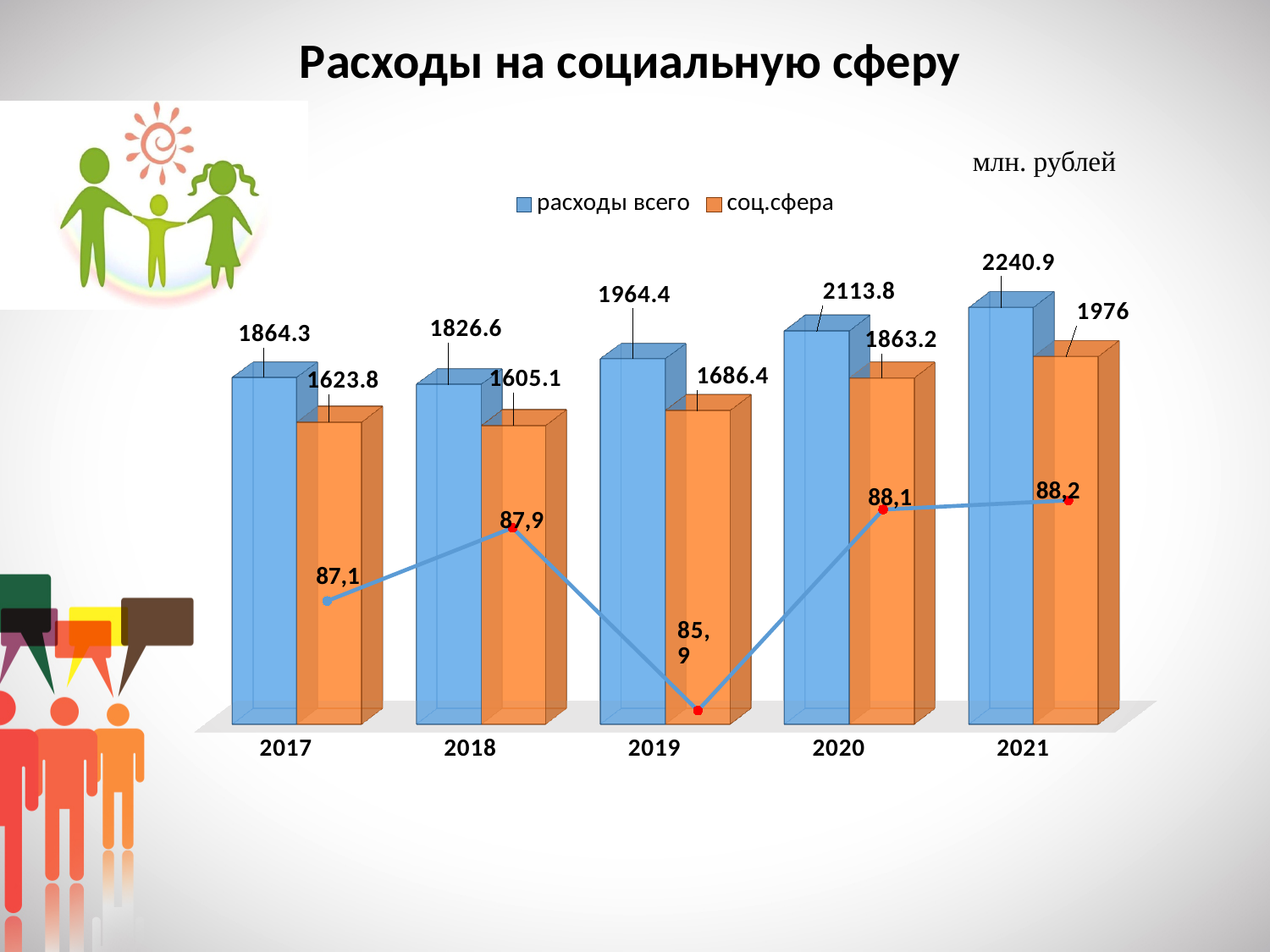
What is the difference between "расходы всего" and "соц.сфера" in 2021? 264.9 Which is larger: "расходы всего" in 2018 or "расходы всего" in 2019? 2019 Which year has the lowest value for "соц.сфера"? 2018 What is the value of "соц.сфера" for 2017? 1623.8 What is the value of "соц.сфера" for 2019? 1686.4 What is the value of "расходы всего" for 2021? 2240.9 Which year has the highest value for "расходы всего"? 2021 How many series does the legend list? 2 What unit is indicated for the chart values? млн. рублей What percentage value is shown on the line for 2019? 85,9 What kind of chart is shown on the slide? Bar chart How many years are shown on the x axis? 5